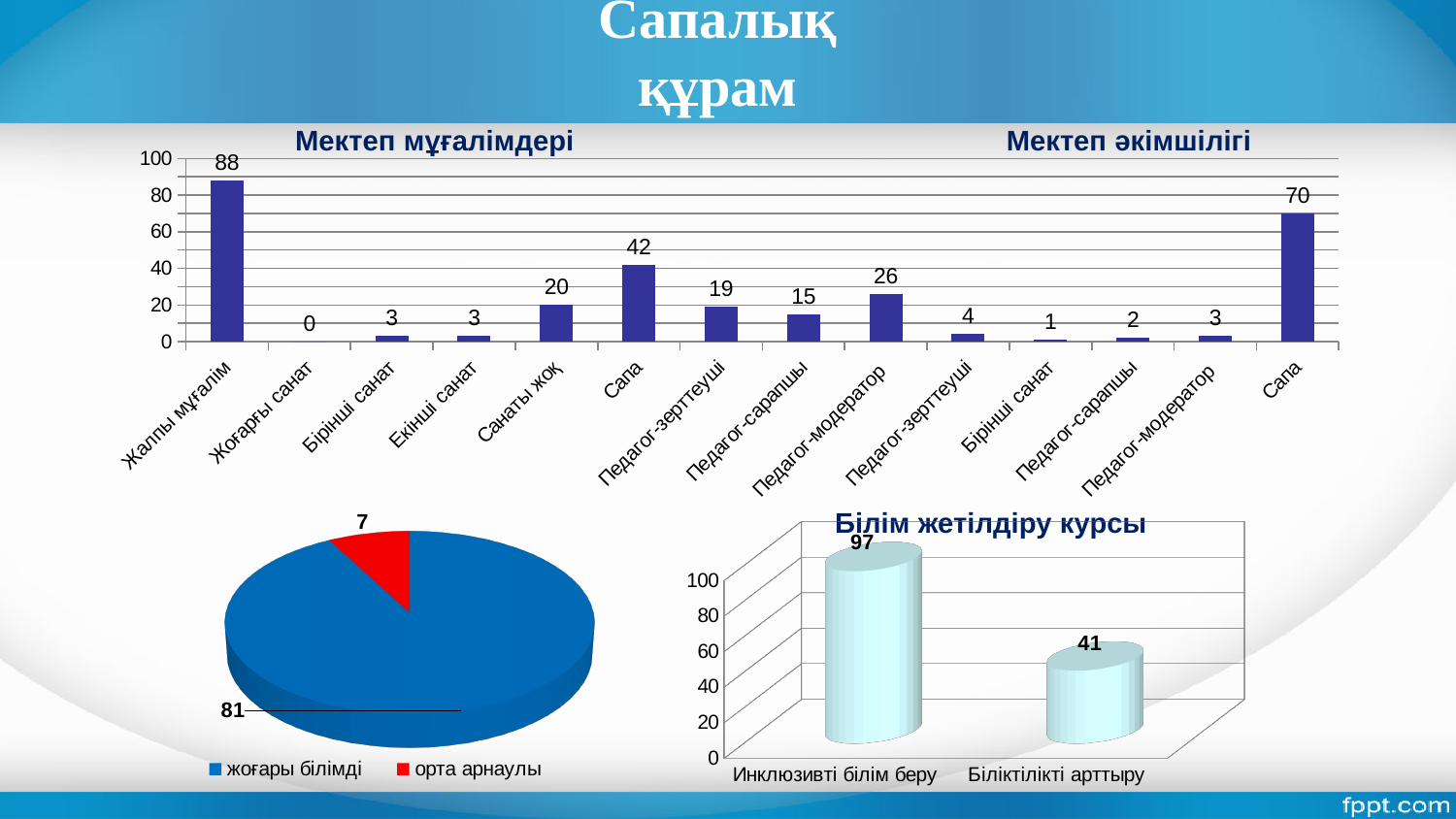
In the Білім жетілдіру курсы chart, what is the value for Біліктілікті арттыру? 41 In the Білім жетілдіру курсы chart, what is the difference between Инклюзивті білім беру and Біліктілікті арттыру? 56 In the top bar chart, which category has the highest value? Жалпы мұғалім In the pie chart at the bottom left, how many entries does the legend list? 2 In the top bar chart, how many categories are shown on the x axis? 14 In the pie chart at the bottom left, which slice is larger, жоғары білімді or орта арнаулы? жоғары білімді In the top bar chart, what is the value for Сапа in the Мектеп әкімшілігі section? 70 In the top bar chart, what is the value for Санаты жоқ? 20 In the top bar chart, which category has the lowest value? Жоғарғы санат In the pie chart at the bottom left, what is the value for орта арнаулы? 7 In the top bar chart, what is the difference between Сапа in the Мектеп мұғалімдері section (42) and Педагог-модератор in the same section (26)? 16 In the top bar chart, what is the value for Жалпы мұғалім? 88